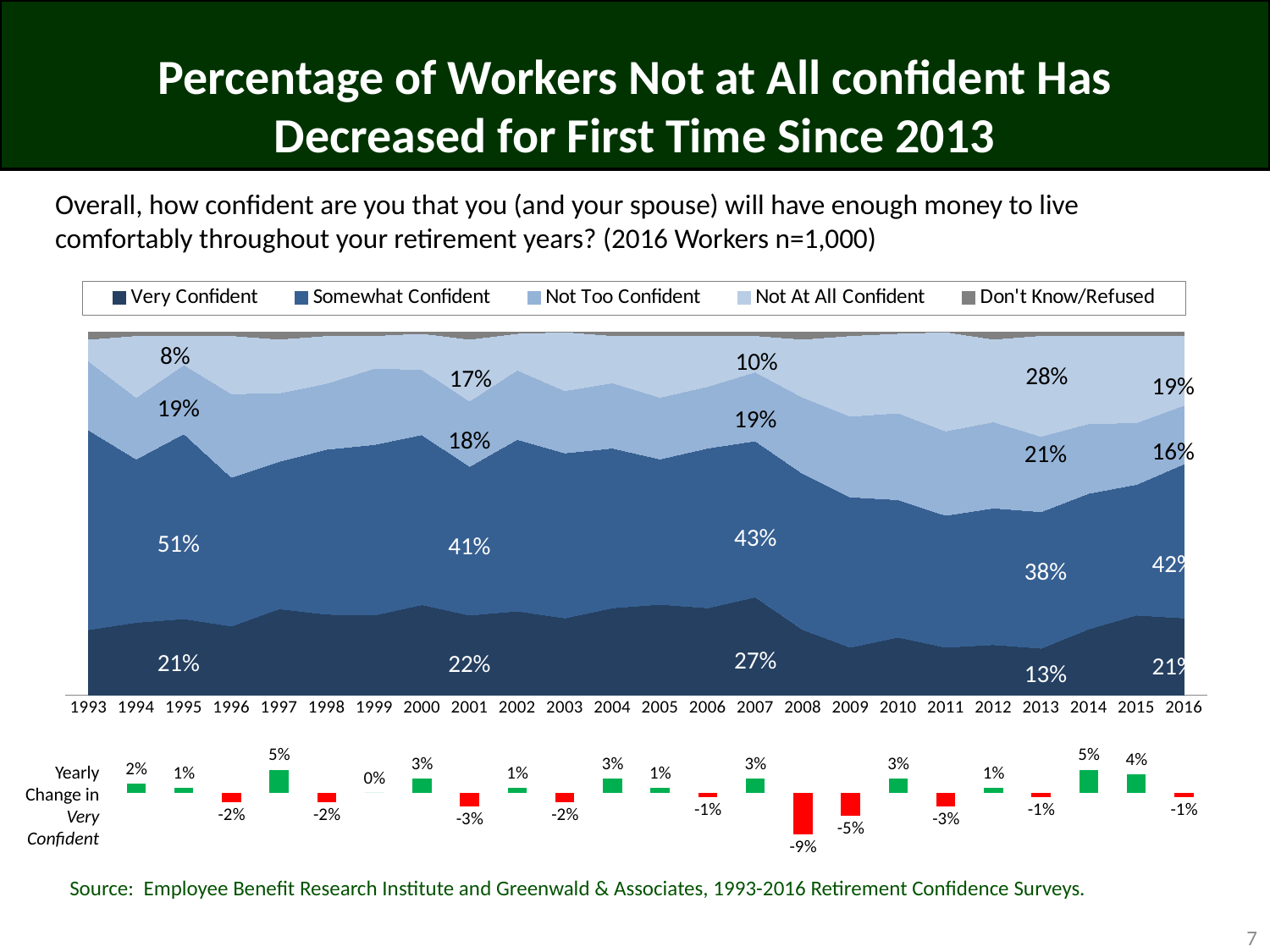
How many years are shown on the x axis of the area chart? 24 In the area chart, what percentage of workers were Not At All Confident in 2001? 17% How many series does the legend of the area chart list? 5 In the area chart, what percentage of workers were Somewhat Confident in 2016? 42% In the area chart, what percentage of workers were Not At All Confident in 2013? 28% What kind of chart is the main chart showing confidence levels from 1993 to 2016? Stacked area chart In the area chart, by how many percentage points did the Not At All Confident share fall from 2013 to 2016? 9 percentage points In the area chart, which year had the larger Very Confident share, 2007 or 2013? 2007 In the Yearly Change in Very Confident bar chart, which year shows the lowest value? 2008 In the area chart, what percentage of workers were Not Too Confident in 2007? 19% In the Yearly Change in Very Confident bar chart, what is the value for 2015? 4%